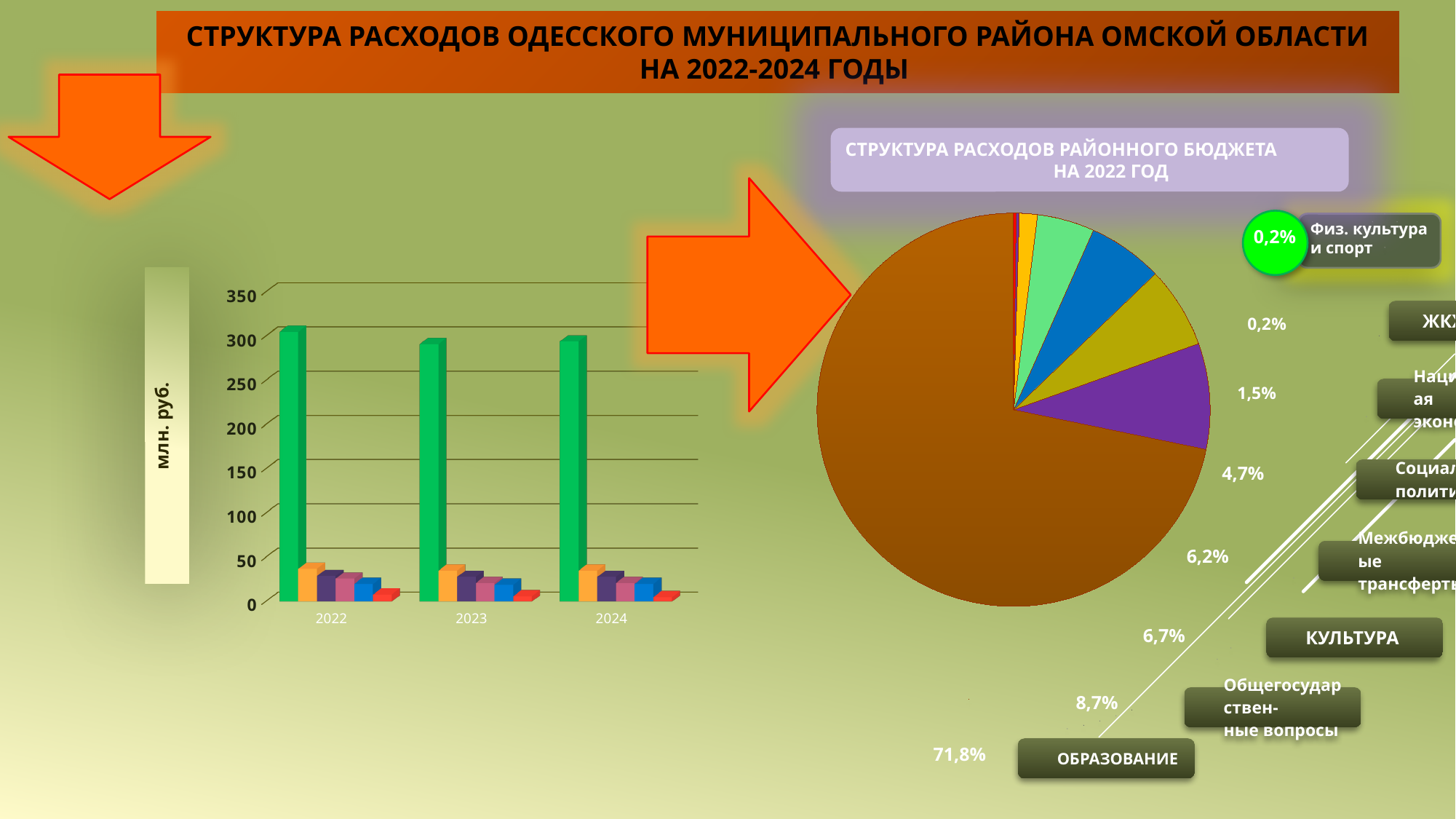
In the pie chart 'СТРУКТУРА РАСХОДОВ РАЙОННОГО БЮДЖЕТА НА 2022 ГОД', which is larger: the share for КУЛЬТУРА or the share for Межбюджетные трансферты? КУЛЬТУРА In the bar chart on the left, is the value of the orange bar for 2022 greater or less than 50? less In the pie chart 'СТРУКТУРА РАСХОДОВ РАЙОННОГО БЮДЖЕТА НА 2022 ГОД', what is the difference between the share for ОБРАЗОВАНИЕ (71,8%) and the share for Общегосударственные вопросы (8,7%)? 63,1% What kind of chart is the chart on the left side of the slide? bar chart In the pie chart 'СТРУКТУРА РАСХОДОВ РАЙОННОГО БЮДЖЕТА НА 2022 ГОД', what share is labelled for Физ. культура и спорт? 0,2% In the pie chart 'СТРУКТУРА РАСХОДОВ РАЙОННОГО БЮДЖЕТА НА 2022 ГОД', what share is labelled for КУЛЬТУРА? 6,7% In the bar chart on the left, is the value of the tallest (green) bar for 2023 greater or less than 300? less In the bar chart on the left, what unit is written on the vertical axis label? млн. руб. In the pie chart 'СТРУКТУРА РАСХОДОВ РАЙОННОГО БЮДЖЕТА НА 2022 ГОД', which category has the largest share? ОБРАЗОВАНИЕ What kind of chart is the chart titled 'СТРУКТУРА РАСХОДОВ РАЙОННОГО БЮДЖЕТА НА 2022 ГОД'? pie chart In the bar chart on the left, how many year categories are shown on the x axis? 3 In the pie chart 'СТРУКТУРА РАСХОДОВ РАЙОННОГО БЮДЖЕТА НА 2022 ГОД', what share is labelled for ОБРАЗОВАНИЕ? 71,8%